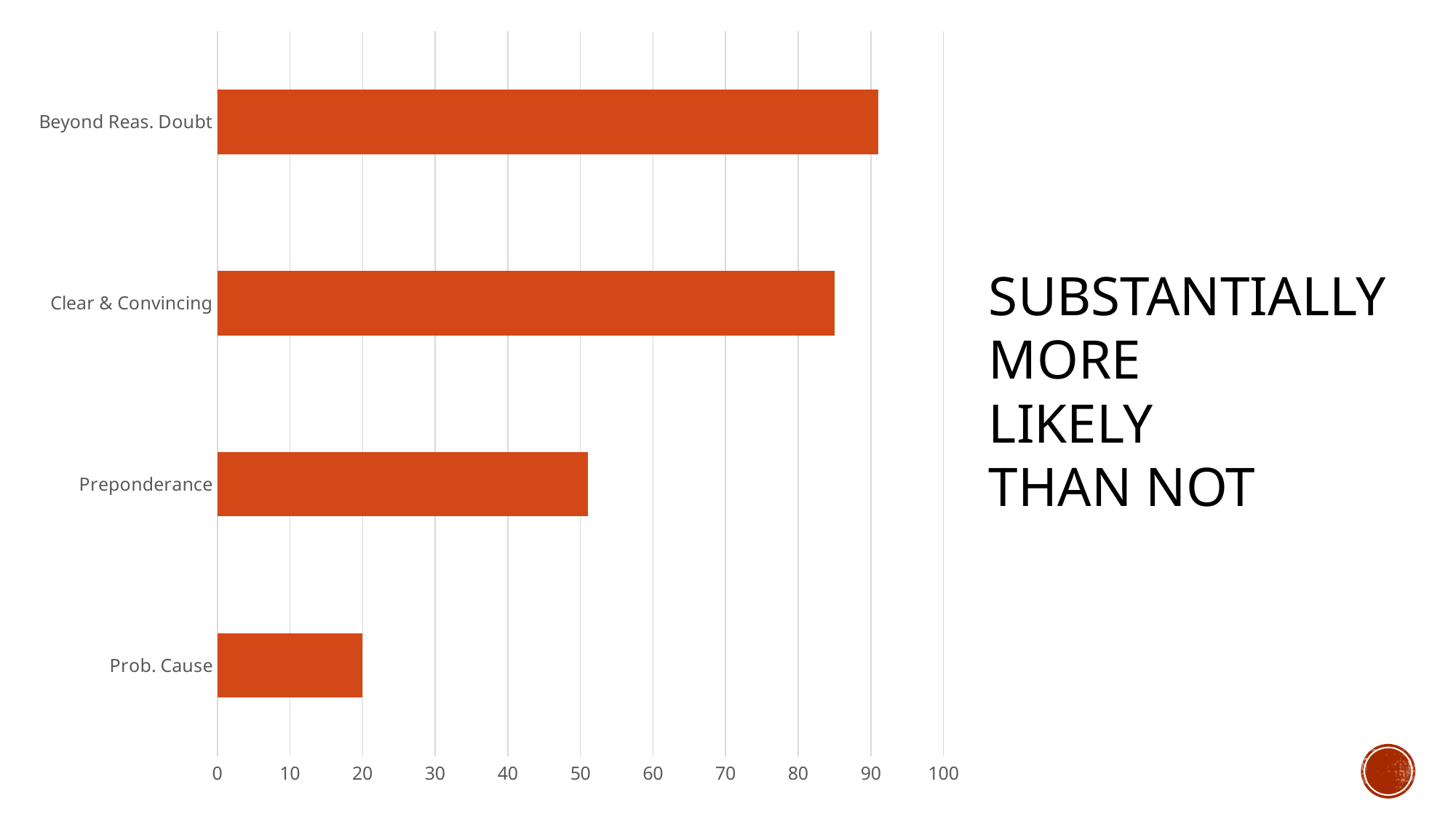
What kind of chart is shown on the slide? bar chart What text appears to the right of the bar chart? SUBSTANTIALLY MORE LIKELY THAN NOT How many categories are plotted in the bar chart? 4 Which category has the highest value in the bar chart? Beyond Reas. Doubt Is the value for Prob. Cause greater or less than 30? less Which category has the lowest value in the bar chart? Prob. Cause Is the value for Preponderance greater or less than 60? less What is the highest value shown on the horizontal axis of the bar chart? 100 Is the value for Clear & Convincing greater or less than 80? greater Which is larger, the value for Clear & Convincing or the value for Preponderance? Clear & Convincing Which is larger, the value for Preponderance or the value for Prob. Cause? Preponderance